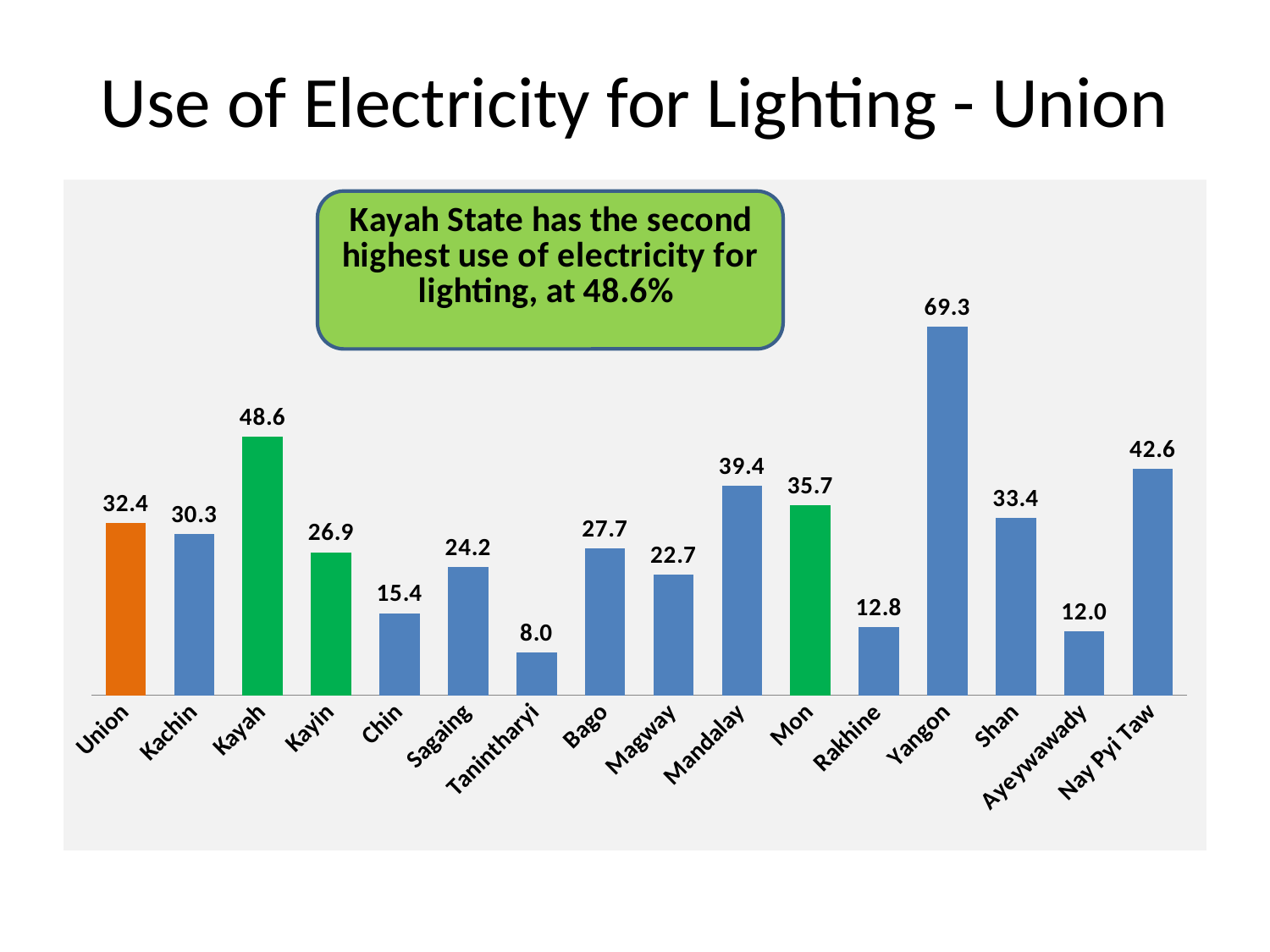
What is the difference between the values for Yangon and Kayah? 20.7 Which category has the highest value? Yangon Which is larger, the value for Shan or the value for Kachin? Shan What is the value for Yangon? 69.3 What colour is the Union bar? Orange How many categories are shown on the x axis? 16 What is the value for Nay Pyi Taw? 42.6 What is the value for Tanintharyi? 8.0 What is the value for Union? 32.4 What kind of chart is this? Bar chart Which category has the lowest value? Tanintharyi What is the difference between the values for Mandalay and Mon? 3.7